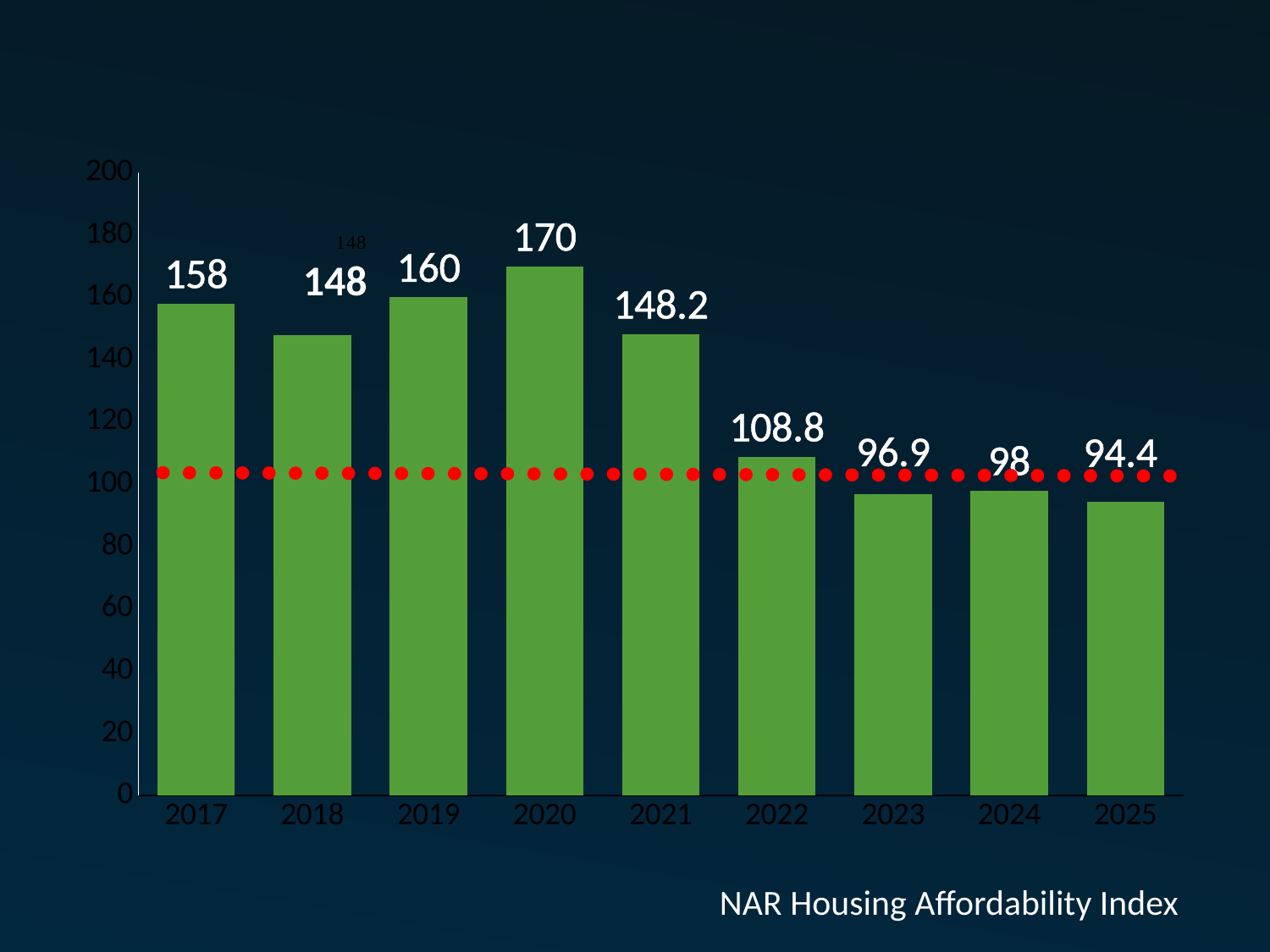
How many years are shown on the x axis? 9 What is the NAR Housing Affordability Index value for 2020? 170 Do the values generally rise or fall from 2020 to 2025? fall What kind of chart is shown on the slide? bar chart What is the difference between the values for 2021 and 2022? 39.4 What is the value shown for 2022? 108.8 Is the value for 2023 greater or less than 100? less What is the difference between the values for 2020 and 2025? 75.6 What is the value shown for 2025? 94.4 Which year has the highest value? 2020 Which year has the lowest value? 2025 Which is larger, the value for 2017 or the value for 2019? 2019